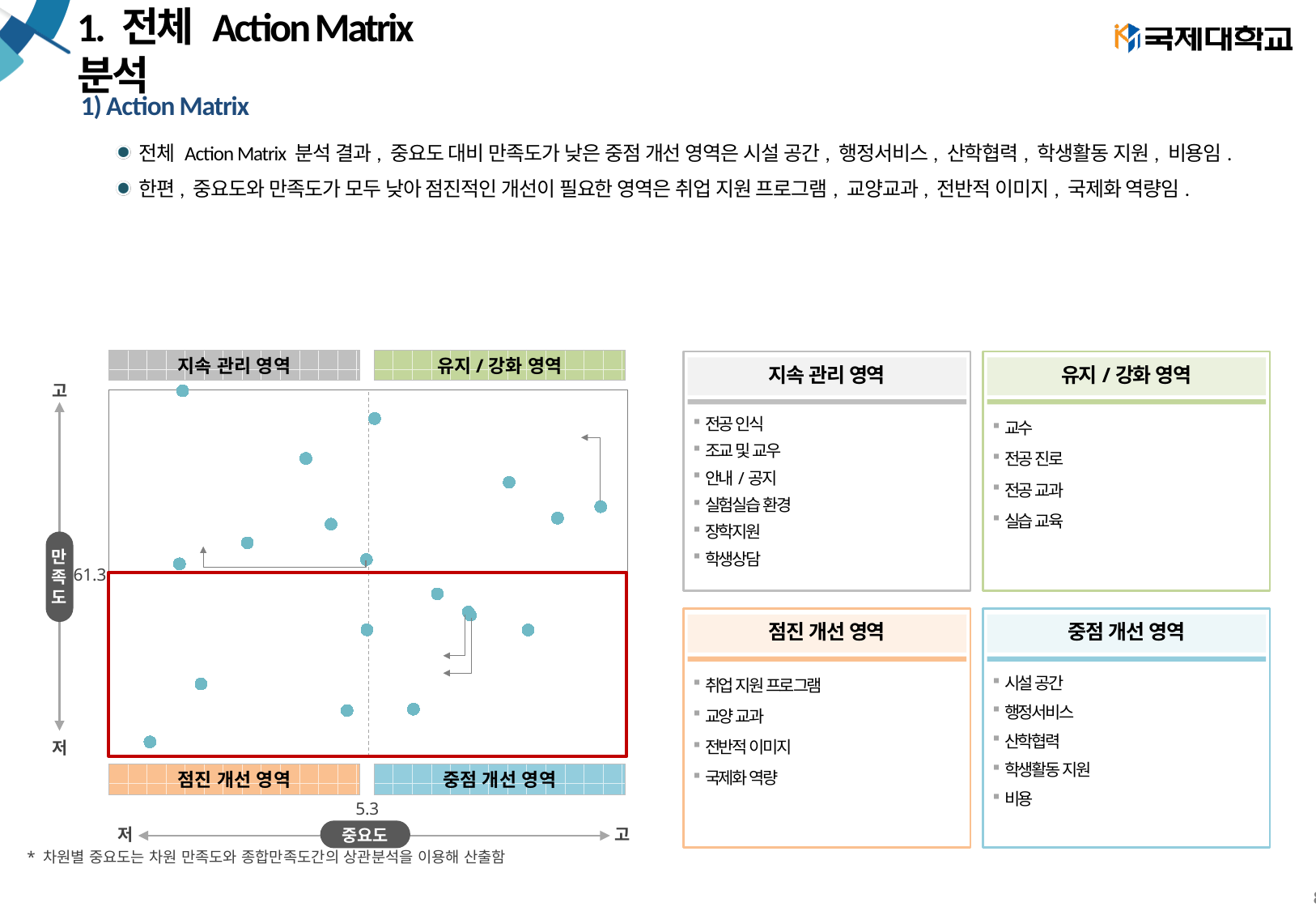
What is the label of the vertical axis of the Action Matrix? 만족도 How many labeled regions (quadrants) is the Action Matrix divided into? 4 What value is marked on the importance (중요도) axis where the vertical dashed dividing line crosses the Action Matrix? 5.3 What value is marked on the satisfaction (만족도) axis where the horizontal dividing line crosses the Action Matrix? 61.3 Which region of the Action Matrix is outlined with a red border? 점진 개선 영역 and 중점 개선 영역 (the entire lower half) What kind of chart is the Action Matrix on the left of the slide? scatter chart